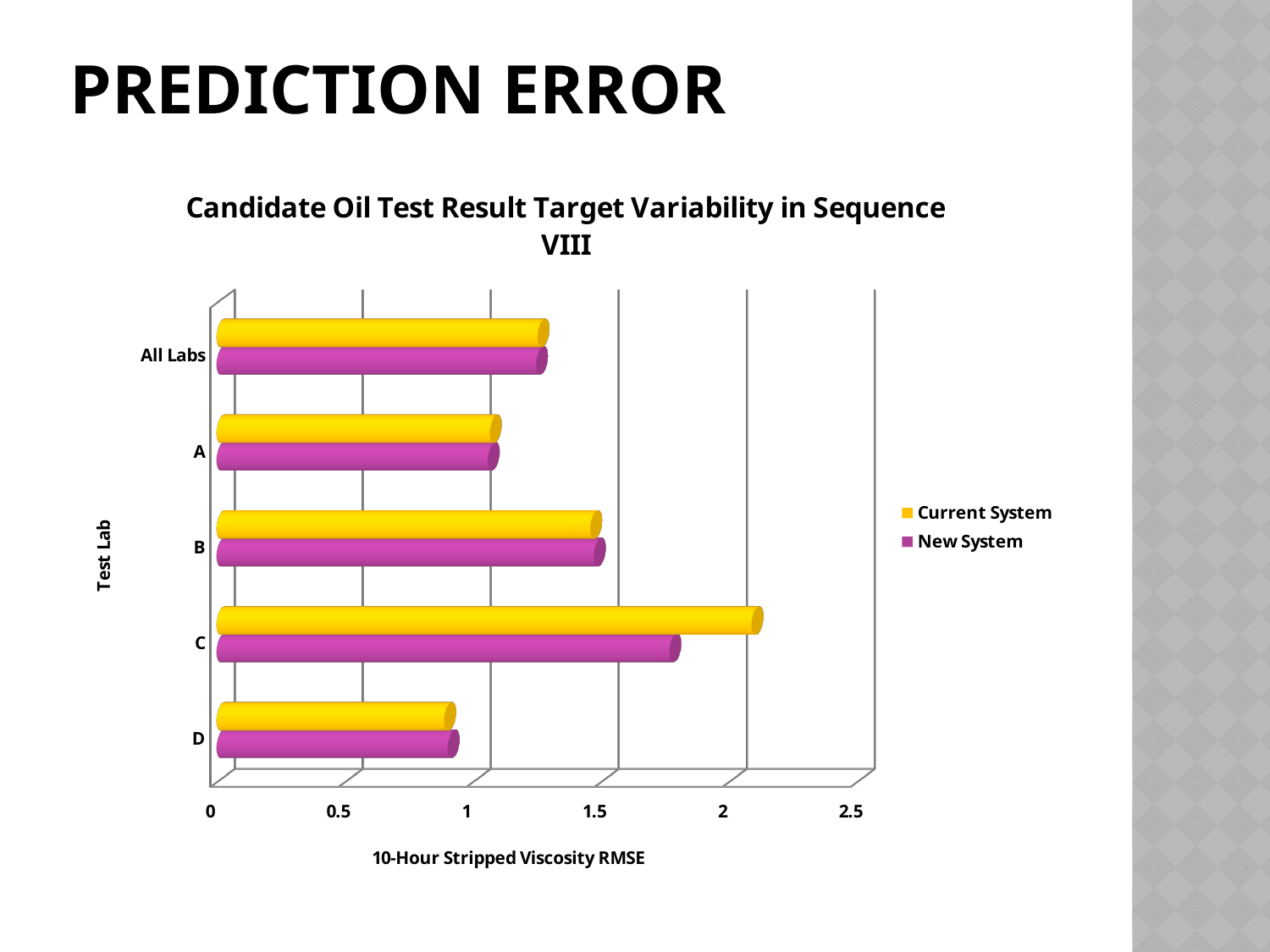
Is the Current System value for test lab C greater or less than 2? greater For test lab C, which is larger: the Current System value or the New System value? Current System What kind of chart is shown on the slide? bar chart Which test lab has the highest Current System value? C How many series does the legend list? 2 Which test lab has the highest New System value? C Is the New System value for test lab C greater or less than 2? less Is the Current System value for test lab D greater or less than 1? less Which test lab has the lowest Current System value? D How many test lab categories are plotted on the chart? 5 What is the label of the horizontal axis? 10-Hour Stripped Viscosity RMSE